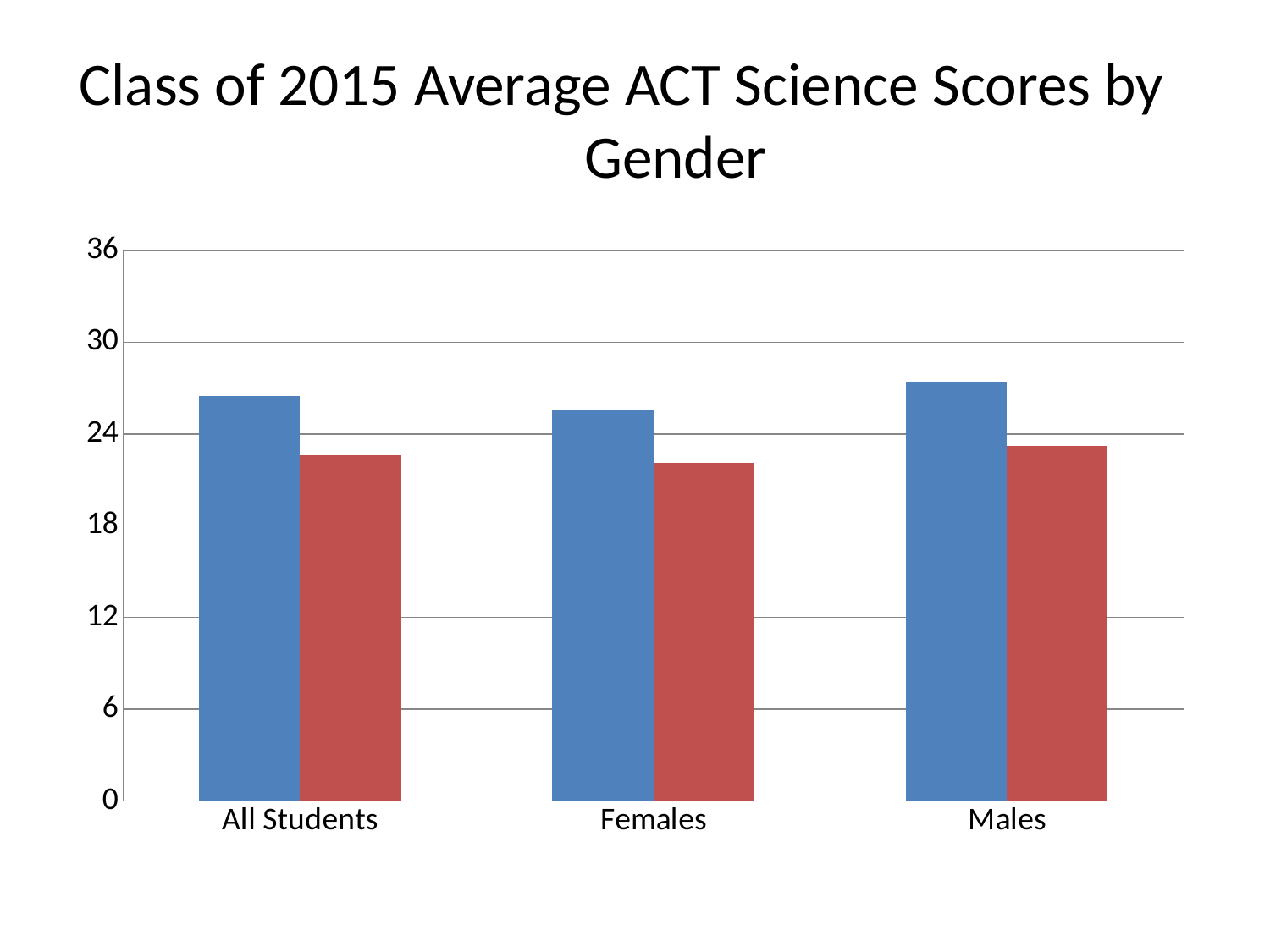
Which category has the shortest blue bar? Females What is the title of the chart? Class of 2015 Average ACT Science Scores by Gender What kind of chart is shown on the slide? bar chart Is the red bar for Females greater or less than 24? less How many bars are shown for each category? 2 Which category has the tallest blue bar? Males What colours are the two bars in each category? blue and red Is the red bar for Males greater or less than 18? greater How many categories are shown on the x axis? 3 For Females, which bar is taller, the blue bar or the red bar? the blue bar Is the blue bar for All Students greater or less than 30? less